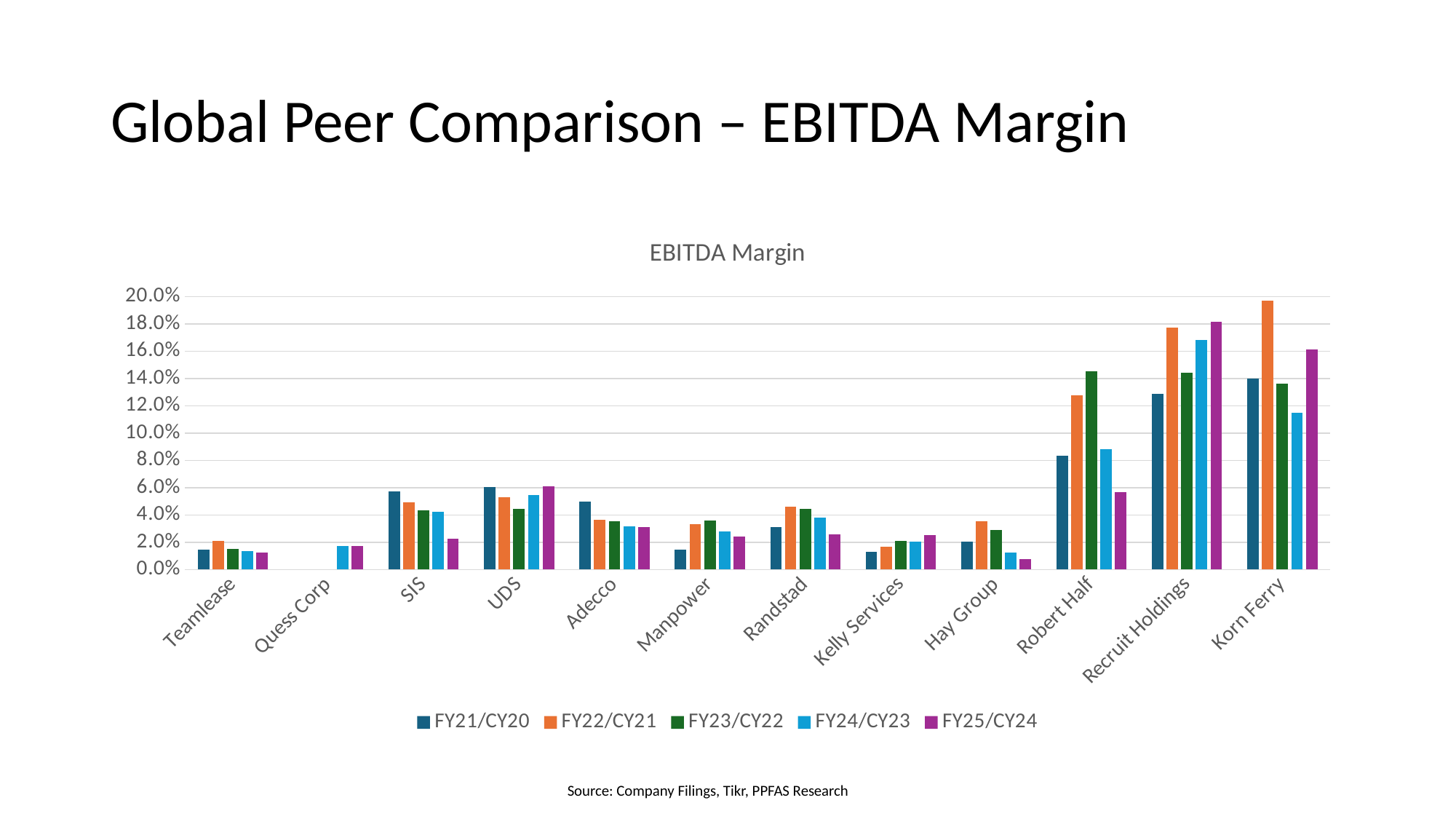
Is the FY22/CY21 value for Korn Ferry greater or less than 18.0%? greater Is the FY23/CY22 value for Robert Half greater or less than 12.0%? greater For Robert Half, which is larger: the FY23/CY22 value or the FY25/CY24 value? FY23/CY22 How many series does the legend list? 5 What is the title shown above the chart? EBITDA Margin How many companies are shown on the x axis? 12 What kind of chart is shown on the slide? Bar chart For Korn Ferry, which series has the highest EBITDA margin? FY22/CY21 From FY22/CY21 to FY25/CY24, do the values for Hay Group rise or fall? fall Is the FY24/CY23 value for Recruit Holdings greater or less than 16.0%? greater Which company has the tallest bar in the chart? Korn Ferry